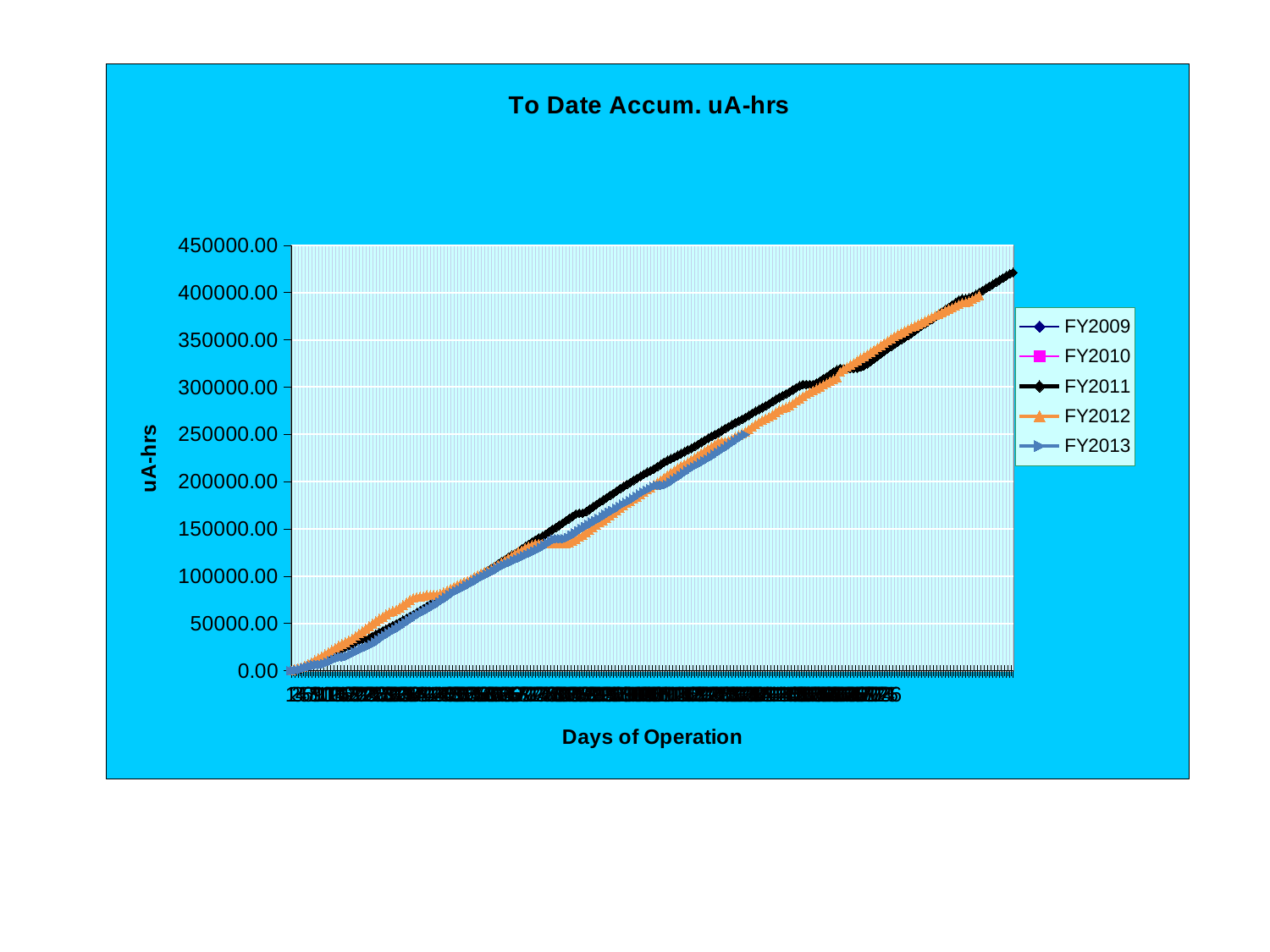
What is the title of the chart? To Date Accum. uA-hrs What is the highest tick value shown on the y axis? 450000.00 What is the label of the x axis? Days of Operation Is the final value of the FY2013 series greater or less than 300000.00? less Is the final value of the FY2013 series greater or less than 200000.00? greater What kind of chart is shown on the slide? line chart Is the final value of the FY2011 series greater or less than 400000.00? greater Which series ends at a higher value, FY2011 or FY2013? FY2011 How many series does the legend list? 5 Do the values of the FY2011 series rise or fall along the x axis? rise Which series reaches the highest accumulated uA-hrs value on the chart? FY2011